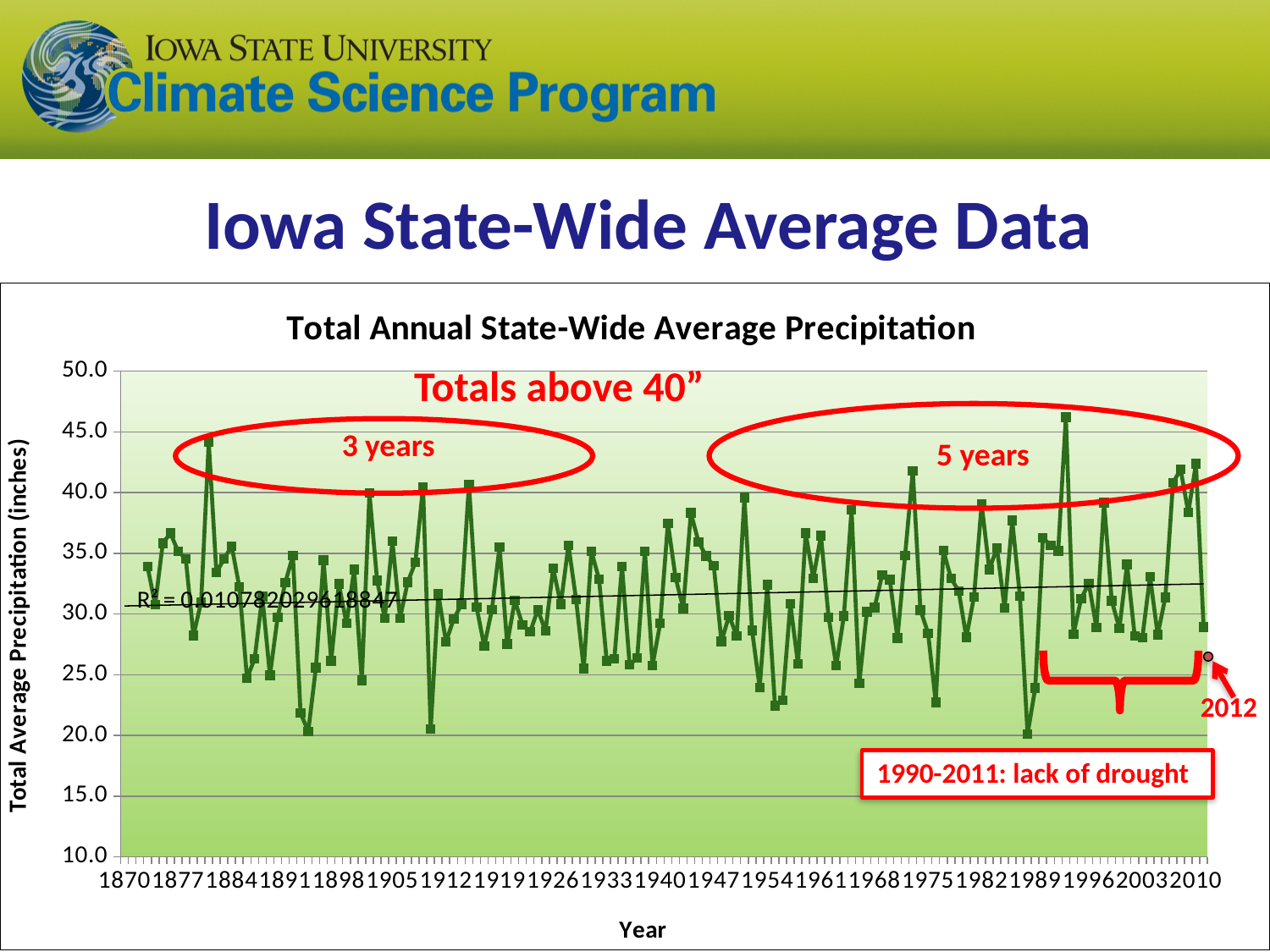
What is the label of the vertical axis of the chart? Total Average Precipitation (inches) Which period does the annotation describe as having a lack of drought? 1990-2011 What is the title of the chart? Total Annual State-Wide Average Precipitation According to the annotation, how many years in the first circled period had totals above 40 inches? 3 years What kind of chart is shown on the slide? line chart How many year labels are shown along the x axis? 21 Is the precipitation value for 2012 greater or less than 30? less According to the annotation, how many years in the second circled period had totals above 40 inches? 5 years